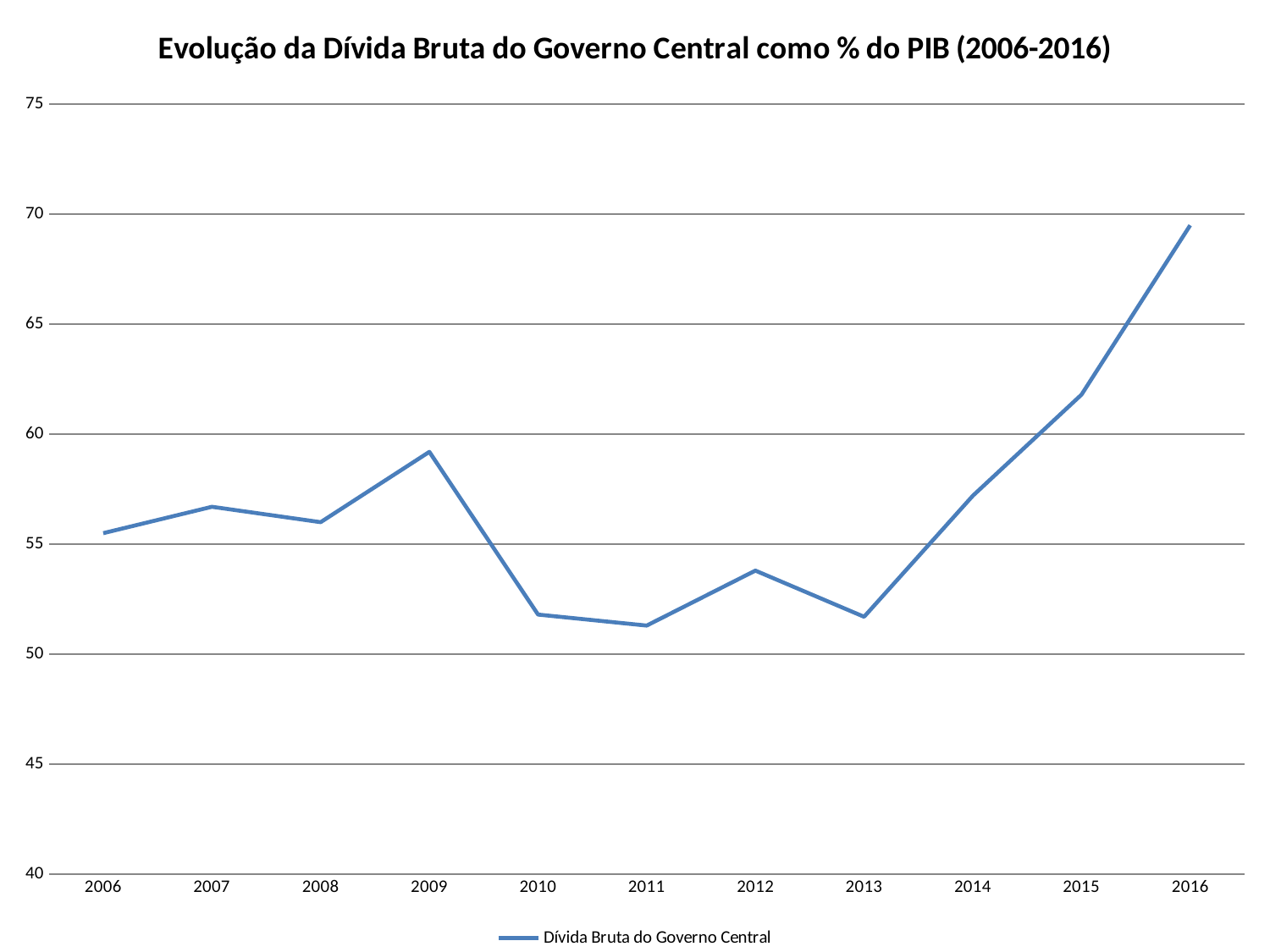
Is the value for 2015 greater or less than 60? greater What is the title of the chart? Evolução da Dívida Bruta do Governo Central como % do PIB (2006-2016) Which year has the larger value, 2009 or 2015? 2015 Is the value for 2009 greater or less than 60? less How many years are plotted along the x axis? 11 How many series does the legend list? 1 Do the values rise or fall from 2013 to 2016? rise Is the value for 2010 greater or less than 55? less What kind of chart is shown on the slide? line chart Which year has the larger value, 2006 or 2010? 2006 Which year has the highest value for Dívida Bruta do Governo Central? 2016